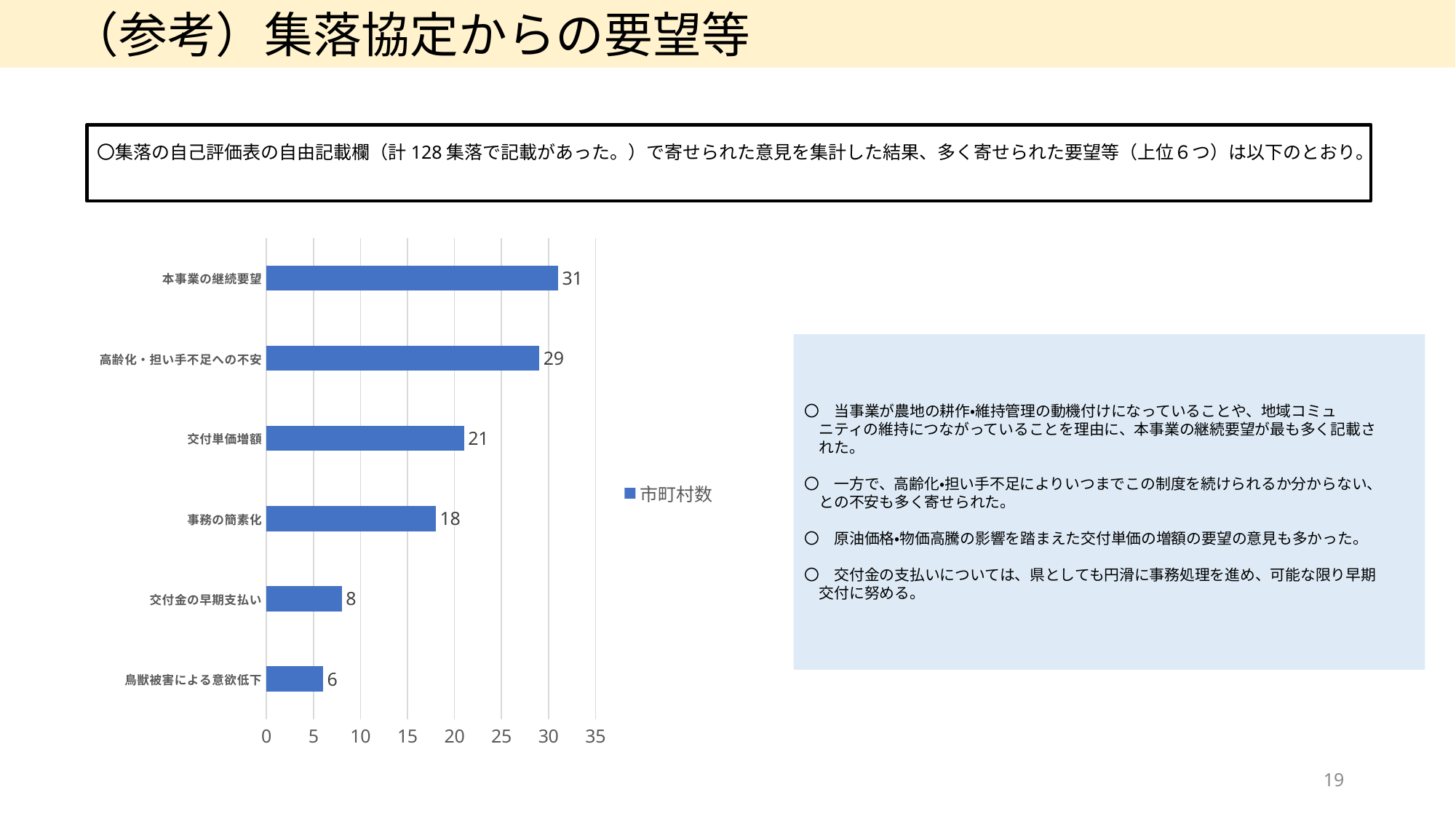
Is the value for 高齢化・担い手不足への不安 greater or less than 25? greater What is the value for 本事業の継続要望? 31 What is the difference between the values for 本事業の継続要望 and 高齢化・担い手不足への不安? 2 What is the value for 交付金の早期支払い? 8 What kind of chart is shown on the slide? bar chart What is the difference between the values for 事務の簡素化 and 鳥獣被害による意欲低下? 12 What is the value for 交付単価増額? 21 What series name does the legend show? 市町村数 Which is larger, the value for 交付単価増額 or the value for 事務の簡素化? 交付単価増額 Which category has the highest value? 本事業の継続要望 How many categories are shown in the chart? 6 Which category has the lowest value? 鳥獣被害による意欲低下